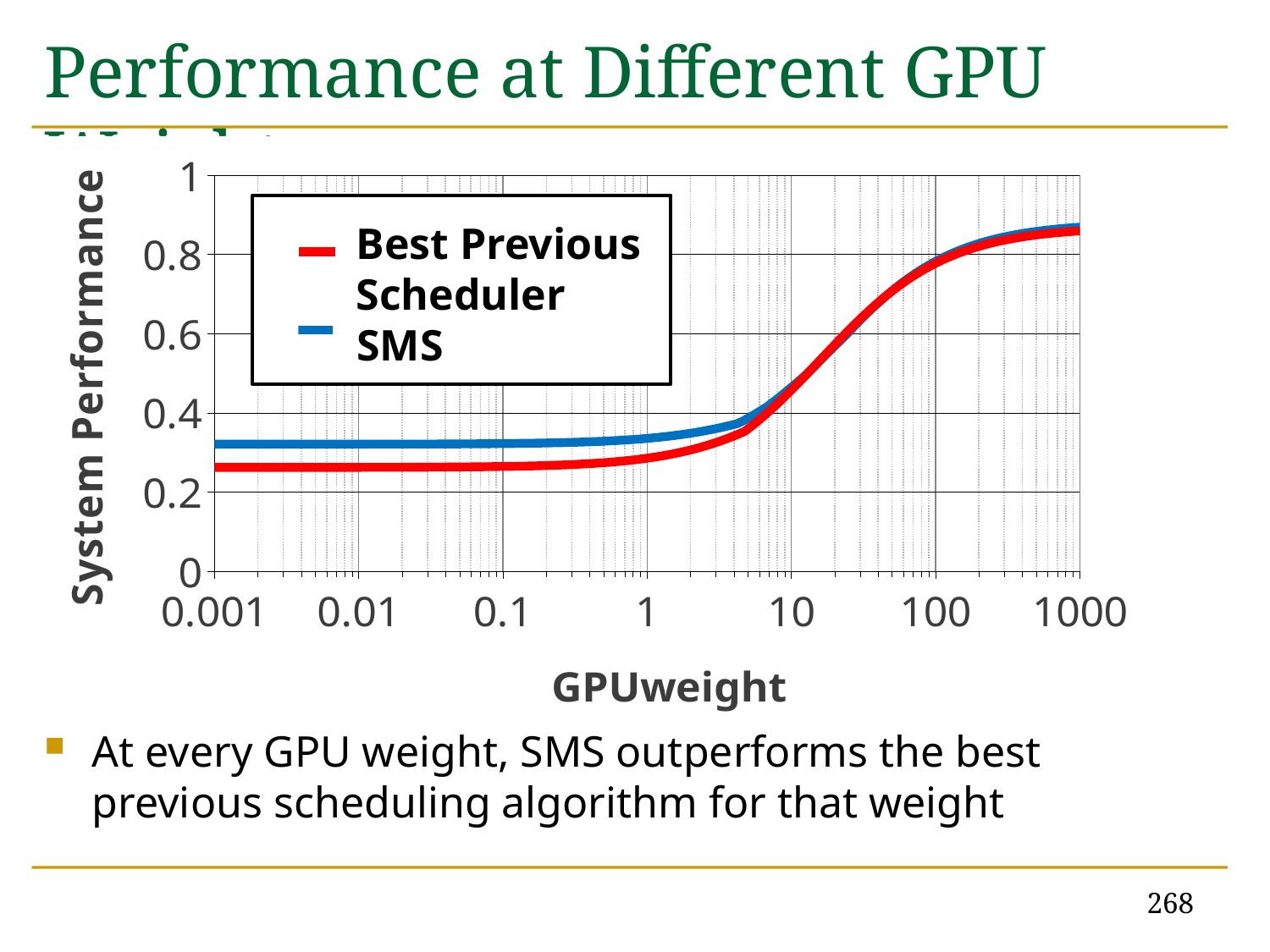
Is the System Performance of Best Previous Scheduler at a GPUweight of 1000 greater or less than 1? less What are the two series named in the legend? Best Previous Scheduler and SMS At a GPUweight of 1, which series has the higher System Performance, SMS or Best Previous Scheduler? SMS Is the System Performance of SMS at a GPUweight of 1000 greater or less than 0.8? greater Is the System Performance of Best Previous Scheduler at a GPUweight of 1 greater or less than 0.4? less How many series does the legend list? 2 Does System Performance rise or fall as GPUweight increases from 0.001 to 1000? rise At a GPUweight of 0.001, which series has the higher System Performance, SMS or Best Previous Scheduler? SMS What is the label of the x axis? GPUweight What kind of chart is shown on the slide? line chart